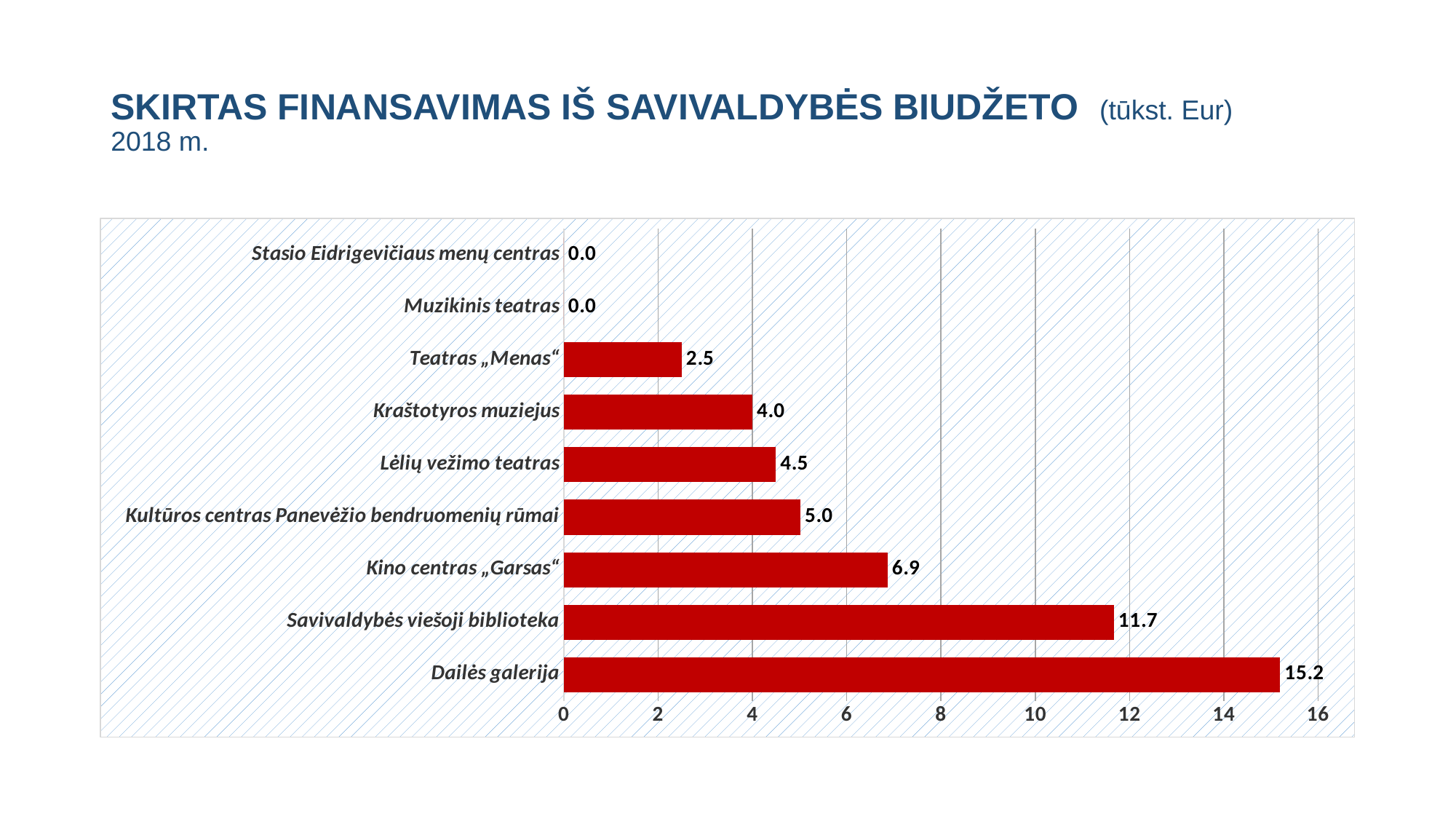
Which category has the highest value? Dailės galerija What is the value for Dailės galerija? 15.2 What is the value for Kino centras „Garsas“? 6.9 Which is larger, the value for Lėlių vežimo teatras or the value for Kraštotyros muziejus? Lėlių vežimo teatras What is the difference between the values for Dailės galerija and Savivaldybės viešoji biblioteka? 3.5 What is the value for Kraštotyros muziejus? 4.0 How many categories are shown in the chart? 9 How many categories have a value of 0.0? 2 What is the value for Savivaldybės viešoji biblioteka? 11.7 What unit is given in the chart title? tūkst. Eur Is the value for Kino centras „Garsas“ greater or less than 8? less What kind of chart is shown on the slide? bar chart